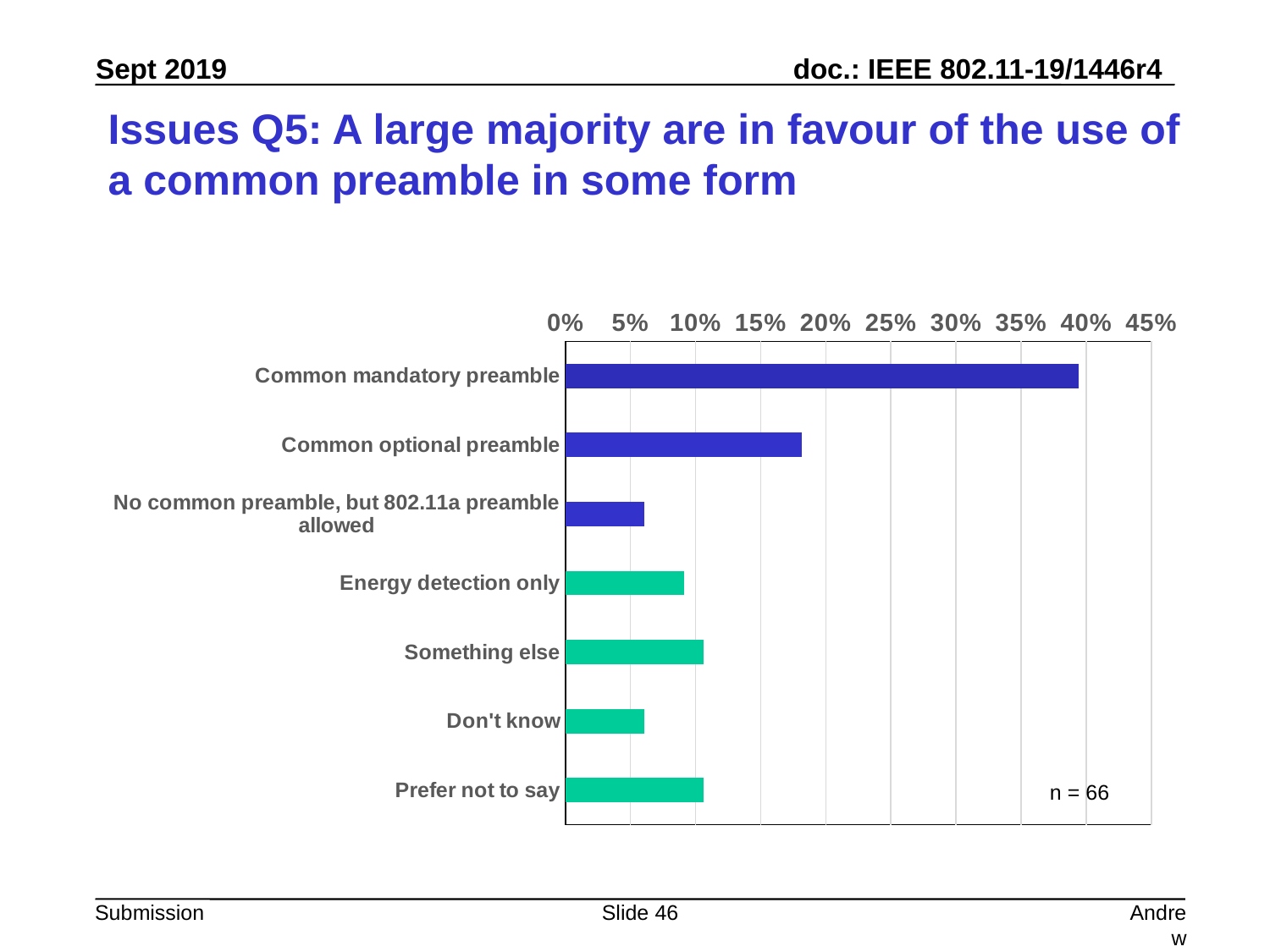
Which is larger, the value for Common optional preamble or the value for Energy detection only? Common optional preamble Is the value for Common mandatory preamble greater or less than 35%? greater Is the value for Something else greater or less than 15%? less How many categories are plotted in the chart? 7 Is the value for Don't know greater or less than 10%? less What sample size (n) is shown on the chart? n = 66 Which category has the highest value in the chart? Common mandatory preamble Which is larger, the value for Common mandatory preamble or the value for Common optional preamble? Common mandatory preamble What kind of chart is shown on the slide? Bar chart Which is larger, the value for Something else or the value for Don't know? Something else